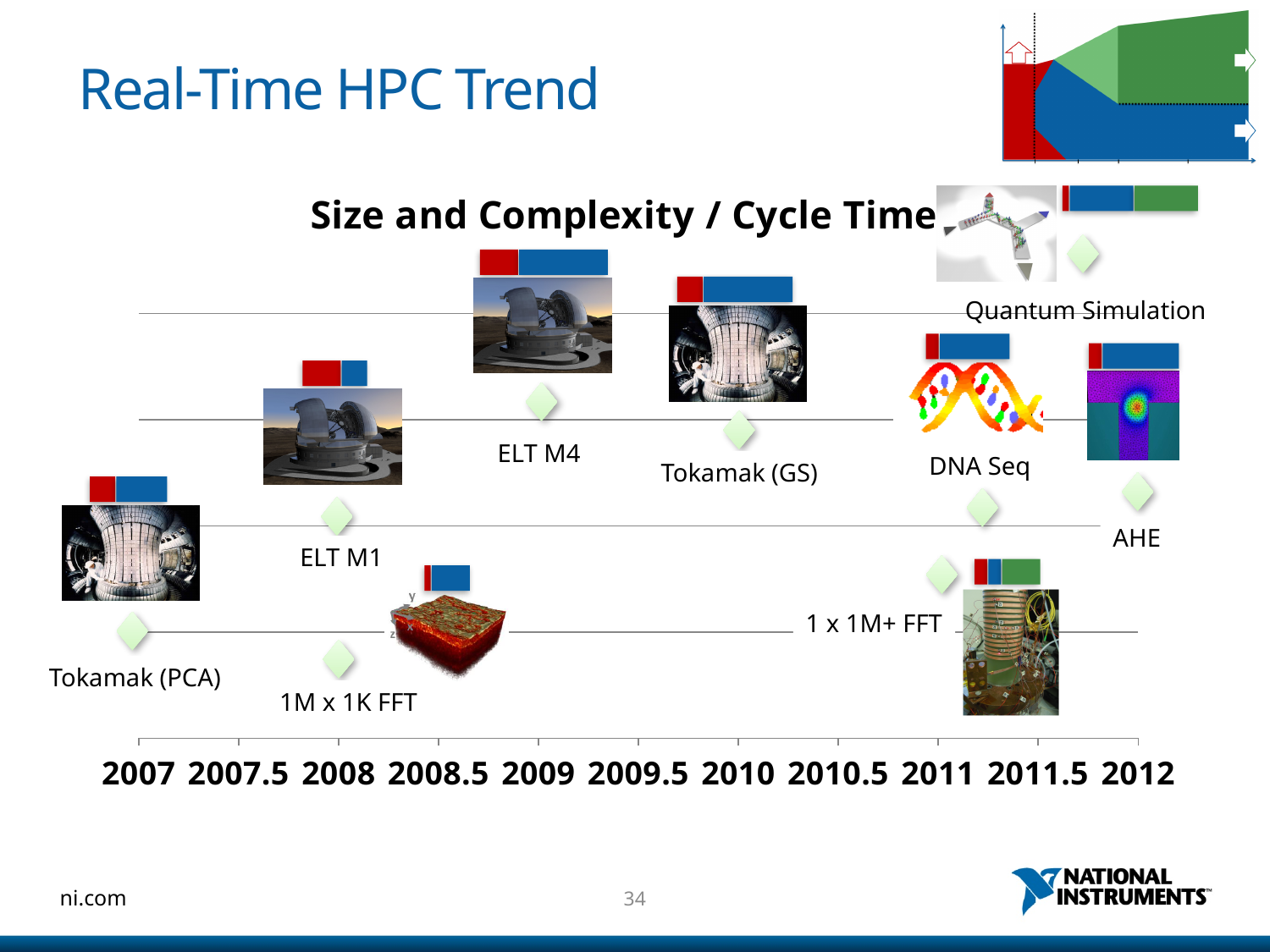
On which x-axis year does the AHE marker land? 2012 On which x-axis year does the ELT M1 marker land? 2008 Which is positioned earlier on the x axis, 1M x 1K FFT or 1 x 1M+ FFT? 1M x 1K FFT What is the earliest year shown on the x axis of the chart? 2007 Which is positioned later on the x axis, Tokamak (GS) or DNA Seq? DNA Seq What is the latest year shown on the x axis of the chart? 2012 On which x-axis year does the Tokamak (PCA) marker land? 2007 Which labeled point is positioned latest along the x axis? AHE What is the title of the chart? Size and Complexity / Cycle Time How many labeled data points are plotted on the chart? 9 Which labeled point is positioned earliest along the x axis? Tokamak (PCA) Is the DNA Seq marker positioned before or after 2011 on the x axis? after